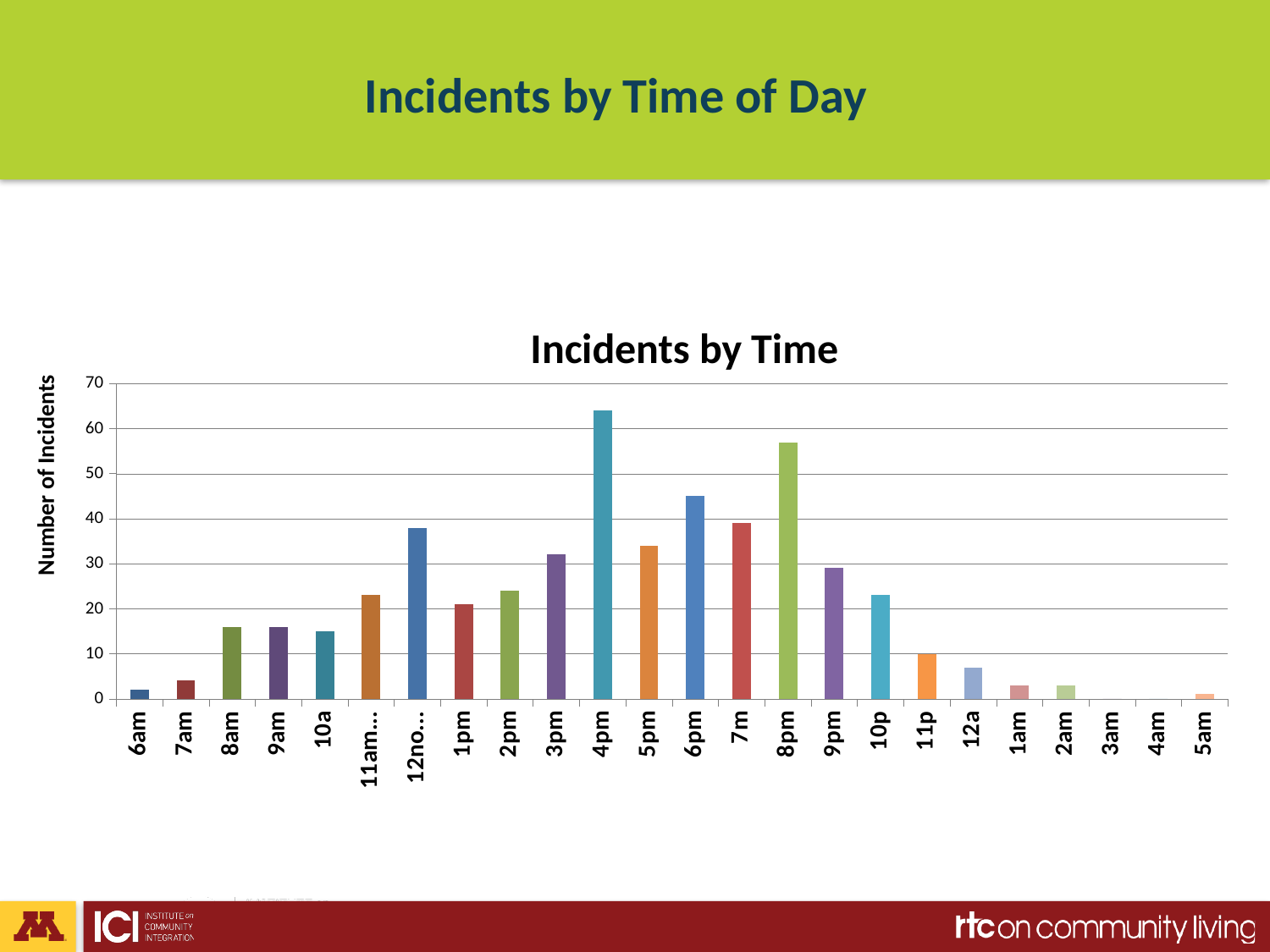
Is the value for 4pm greater or less than 60? greater Do the values generally rise or fall from 4pm through to 3am? fall Is the value for 8am greater or less than 10? greater Which has more incidents, 6pm or 5pm? 6pm What is the title of the vertical axis? Number of Incidents Is the value for 5pm greater or less than 30? greater Which time of day has the highest number of incidents? 4pm How many time-of-day categories are plotted on the x axis? 24 What kind of chart is shown on the slide? bar chart Which has more incidents, 4pm or 8pm? 4pm